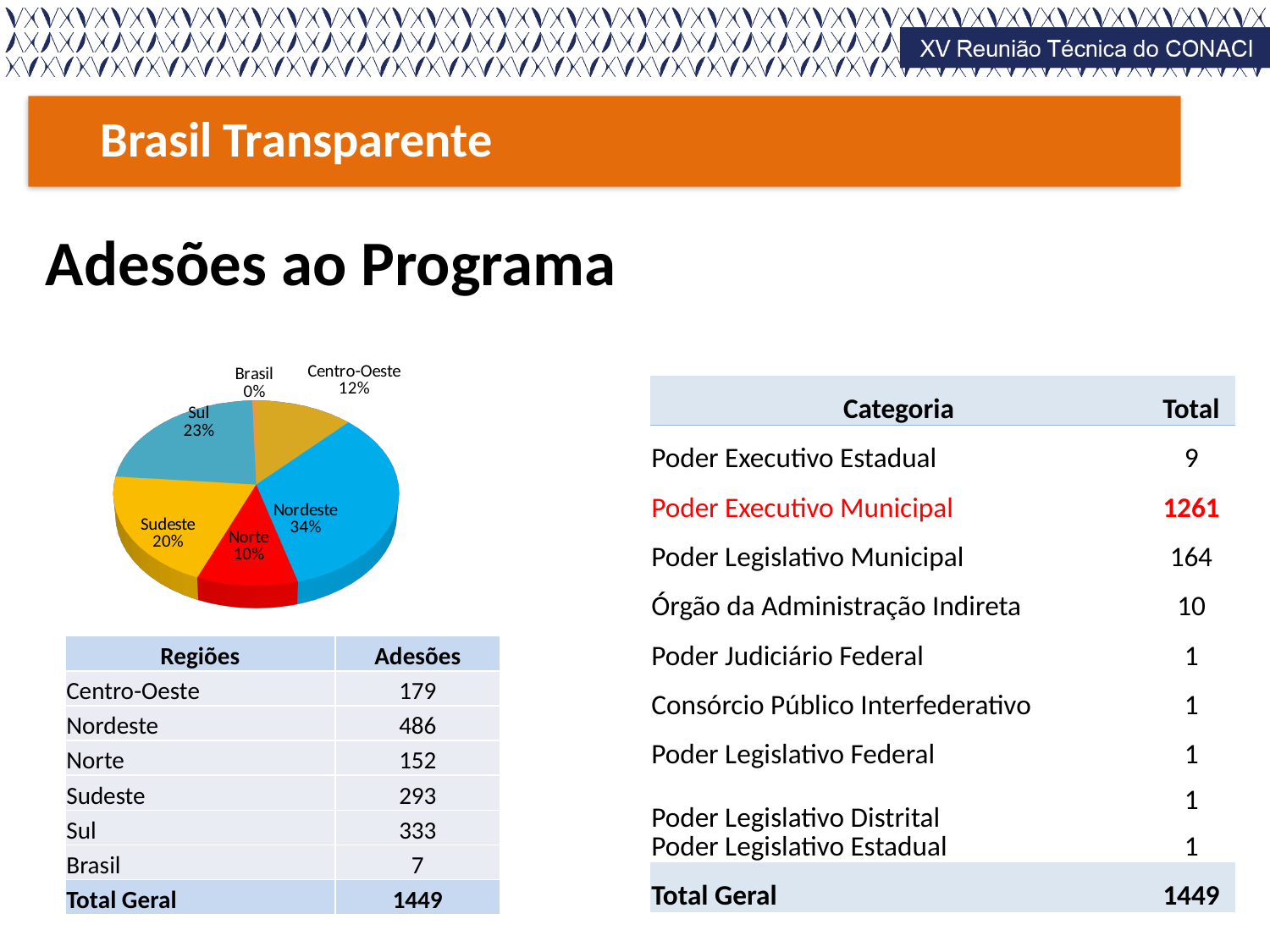
What percentage share does the Sudeste slice have in the pie chart? 20% What percentage share does the Centro-Oeste slice have in the pie chart? 12% What percentage share does the Nordeste slice have in the pie chart? 34% What percentage is shown for the Brasil slice in the pie chart? 0% Which slice of the pie chart has the smallest share? Brasil What is the difference in percentage points between the Nordeste and Norte slices in the pie chart? 24 Which slice of the pie chart has the largest share? Nordeste How many slices are labelled in the pie chart? 6 Which slice has a larger share in the pie chart, Sul or Sudeste? Sul What kind of chart is shown on the slide? pie chart